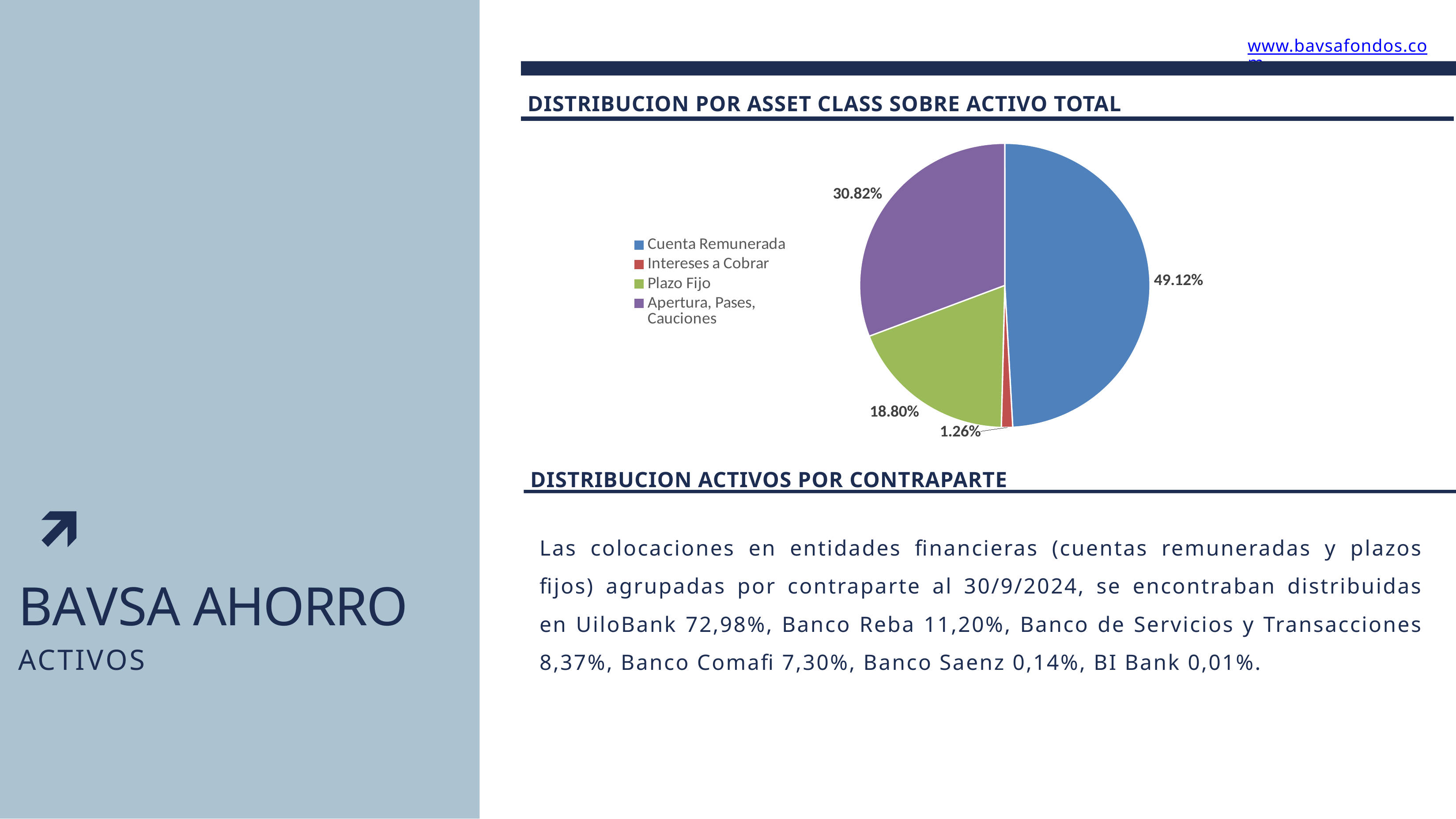
What kind of chart is shown on the slide? Pie chart What is the difference between the shares of Cuenta Remunerada and Apertura, Pases, Cauciones? 18.30% What colour is the Plazo Fijo slice in the pie chart? Green What share of the pie does Plazo Fijo represent? 18.80% What share of the pie does Apertura, Pases, Cauciones represent? 30.82% Which category has the smallest slice of the pie? Intereses a Cobrar What share of the pie does Intereses a Cobrar represent? 1.26% Which category has the largest slice of the pie? Cuenta Remunerada Which is larger, the share of Plazo Fijo or the share of Apertura, Pases, Cauciones? Apertura, Pases, Cauciones How many categories does the pie chart show? 4 What is the title of the pie chart? DISTRIBUCION POR ASSET CLASS SOBRE ACTIVO TOTAL